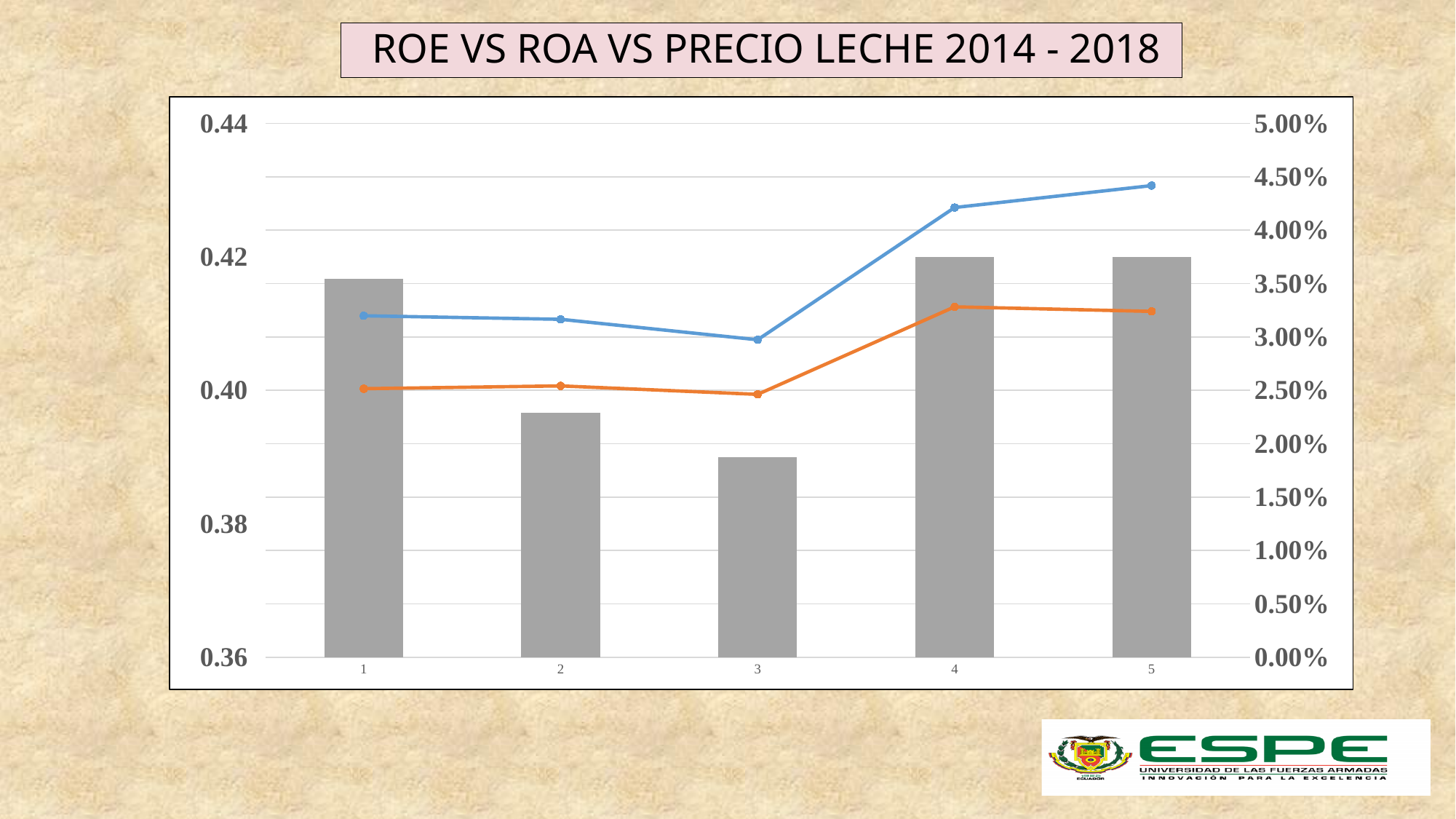
Is the gray bar for category 3 greater or less than 0.40 on the left axis? less What kind of chart is shown on the slide? A combined bar and line chart Is the orange line value at category 1 greater or less than 3.00% on the right axis? less Is the blue line value at category 4 greater or less than 4.00% on the right axis? greater Does the blue line rise or fall from category 3 to category 5? Rises Which category has the lowest gray bar? 3 How many categories are shown on the x axis? 5 What is the title of the chart? ROE VS ROA VS PRECIO LECHE 2014 - 2018 Which is taller, the gray bar for category 1 or the gray bar for category 2? Category 1 At which category does the blue line reach its highest value? 5 At which category does the blue line reach its lowest value? 3